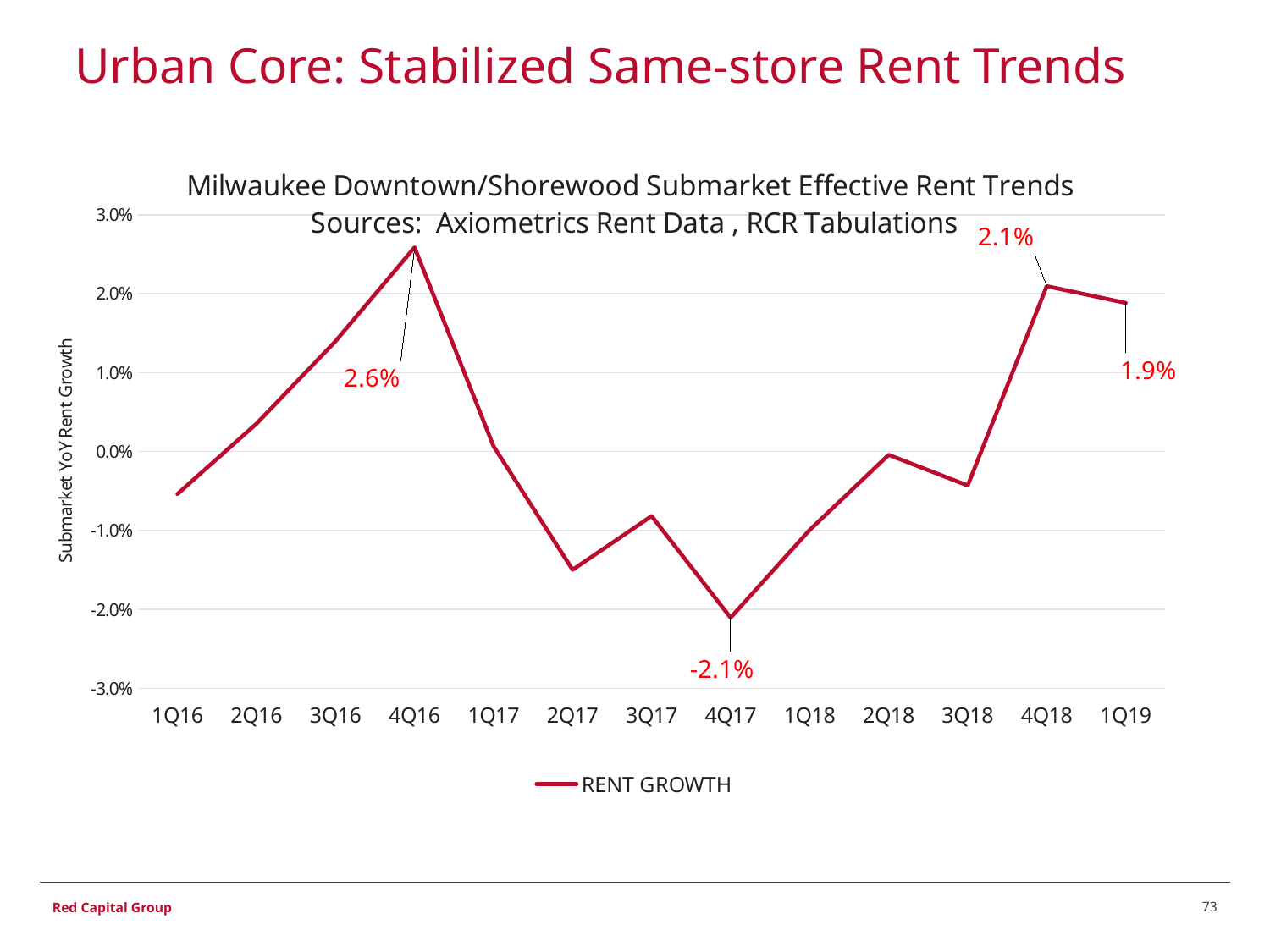
Is the value for 2Q17 greater or less than -1.0%? less Which quarter has the highest rent growth? 4Q16 Which is larger, the rent growth in 4Q18 or in 1Q19? 4Q18 What series name is shown in the legend? RENT GROWTH Which quarter has the lowest rent growth? 4Q17 What type of chart is shown on the slide? Line chart How many quarters are plotted on the x axis? 13 Does the rent growth rise or fall from 4Q17 to 4Q18? Rise What is the rent growth value for 1Q19? 1.9% What is the rent growth value for 4Q16? 2.6% What is the rent growth value for 4Q17? -2.1% What is the difference between the rent growth in 4Q16 and 4Q18? 0.5 percentage points